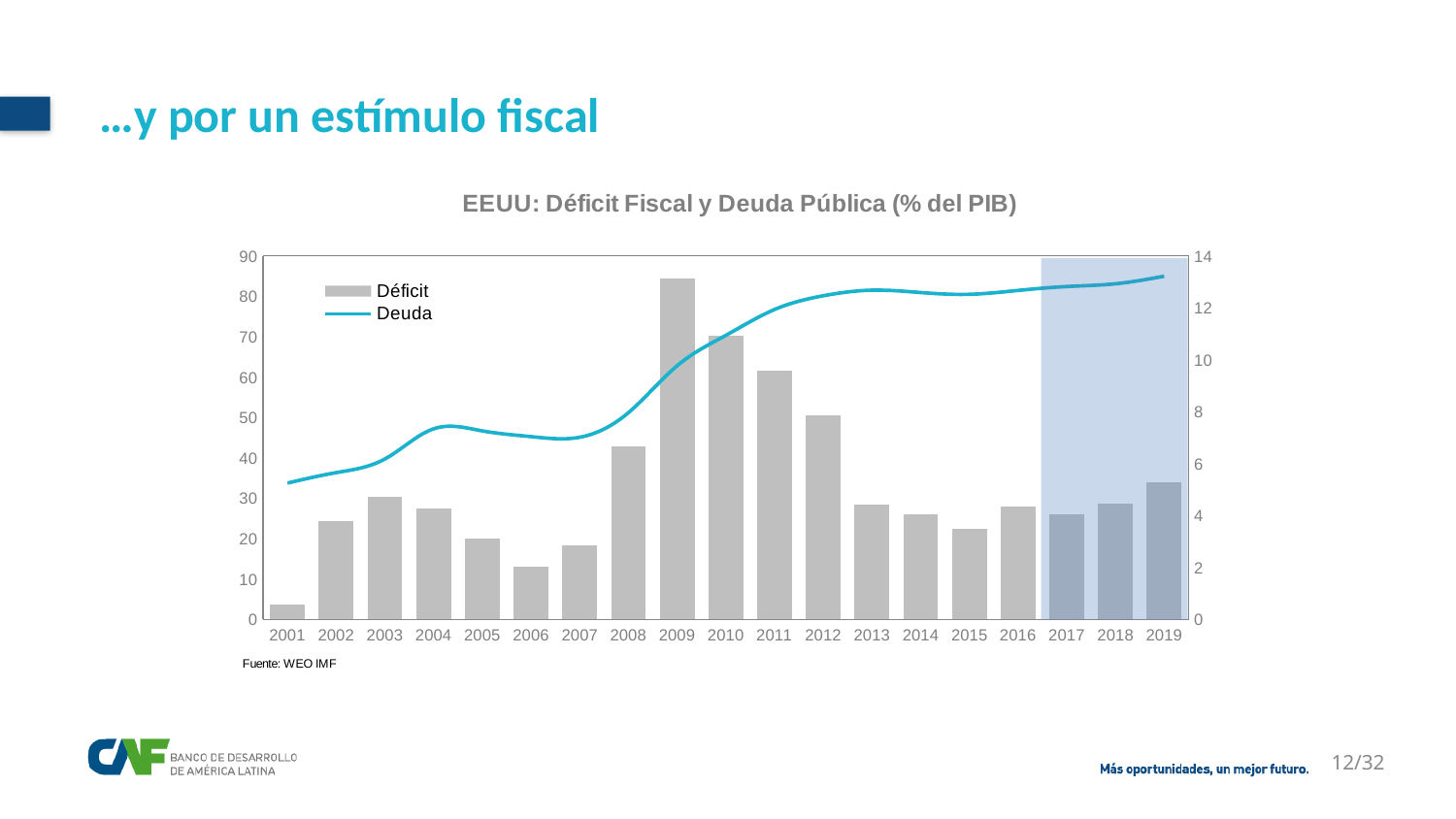
What is the title of the chart? EEUU: Déficit Fiscal y Deuda Pública (% del PIB) Which year has the larger Déficit bar, 2009 or 2010? 2009 In which year is the Déficit bar the highest? 2009 Is the Deuda value for 2019 greater or less than 12 on the right axis? greater How many years are shown on the x axis? 19 How many series does the chart legend list? 2 Which series is drawn as a line rather than bars? Deuda Does the Deuda line generally rise or fall from 2001 to 2019? rise Is the Déficit value for 2006 greater or less than 20 on the left axis? less In which year is the Déficit bar the lowest? 2001